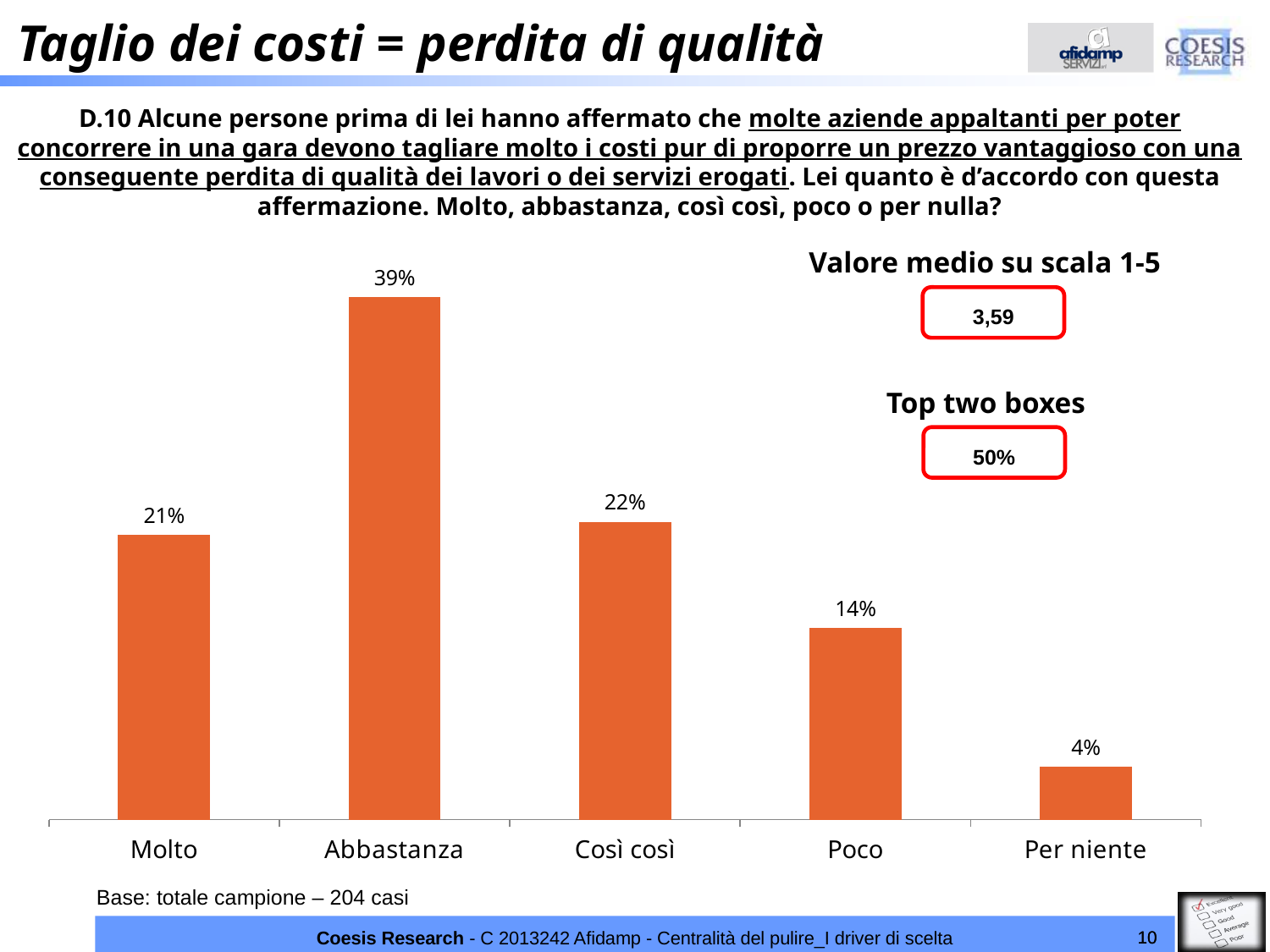
What kind of chart is shown on the slide? Bar chart Which category has the highest value? Abbastanza How many categories are shown on the x axis? 5 What is the total of the values for Molto and Abbastanza? 60% What value is shown in the box under 'Valore medio su scala 1-5'? 3,59 Which is larger, the value for Molto or the value for Poco? Molto What is the value for Abbastanza? 39% Which category has the lowest value? Per niente What is the value for Molto? 21% What is the value for Per niente? 4% What is the value for Poco? 14% What is the difference between the values for Abbastanza and Così così? 17%